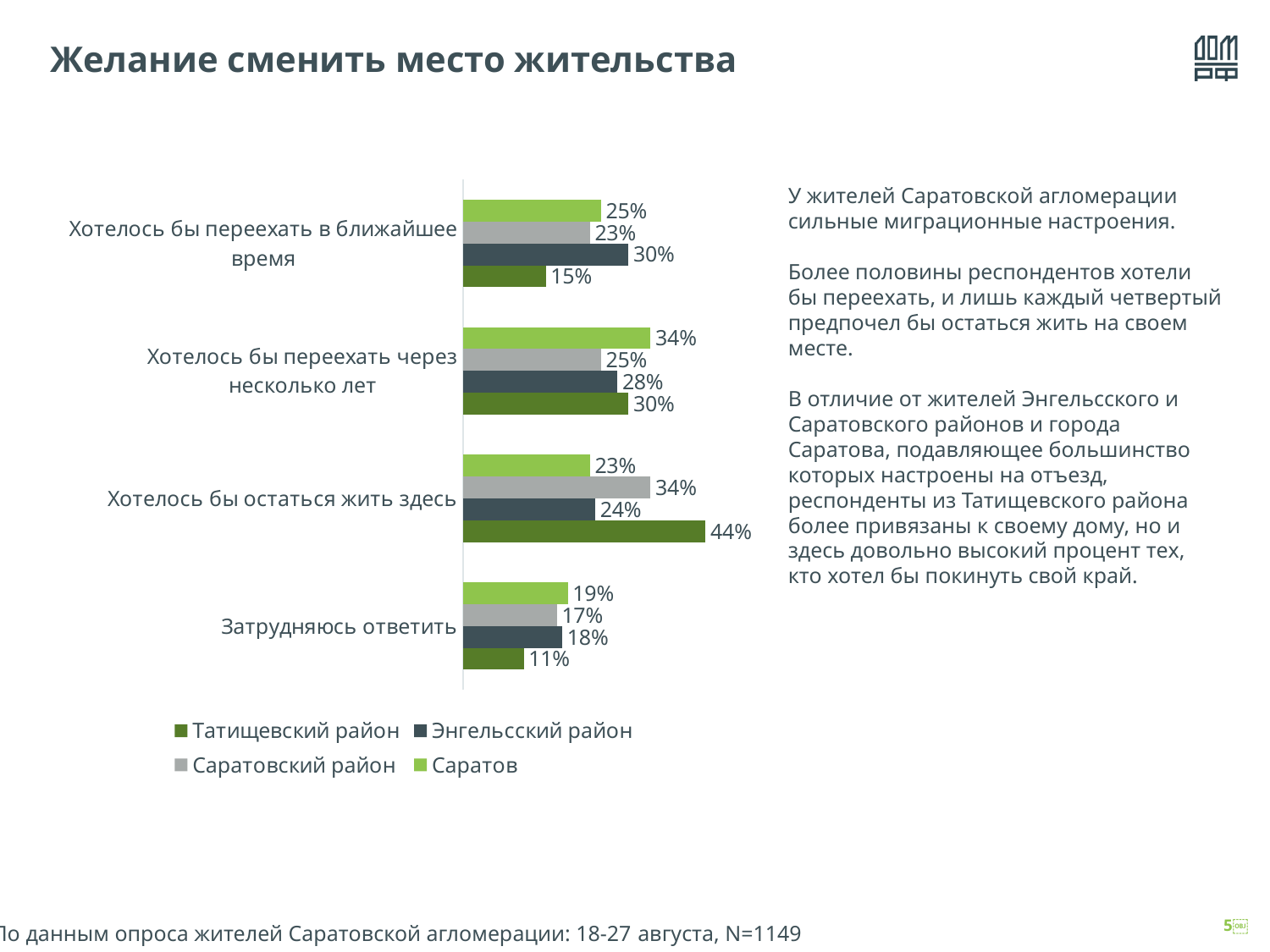
What is the difference between Татищевский район and Саратов in the category 'Хотелось бы остаться жить здесь'? 21% What type of chart is shown on the slide? Bar chart What is the value for Энгельсский район in the category 'Хотелось бы переехать в ближайшее время'? 30% Which series is shown in light green in the legend? Саратов What is the value for Саратовский район in the category 'Затрудняюсь ответить'? 17% Which series has the highest value in the category 'Хотелось бы остаться жить здесь'? Татищевский район In the category 'Затрудняюсь ответить', which is larger: Саратов or Татищевский район? Саратов How many series does the legend list? 4 What is the value for Саратов in the category 'Хотелось бы переехать через несколько лет'? 34% Which series has the lowest value in the category 'Хотелось бы переехать в ближайшее время'? Татищевский район What is the value for Татищевский район in the category 'Хотелось бы остаться жить здесь'? 44% How many categories are shown on the chart? 4